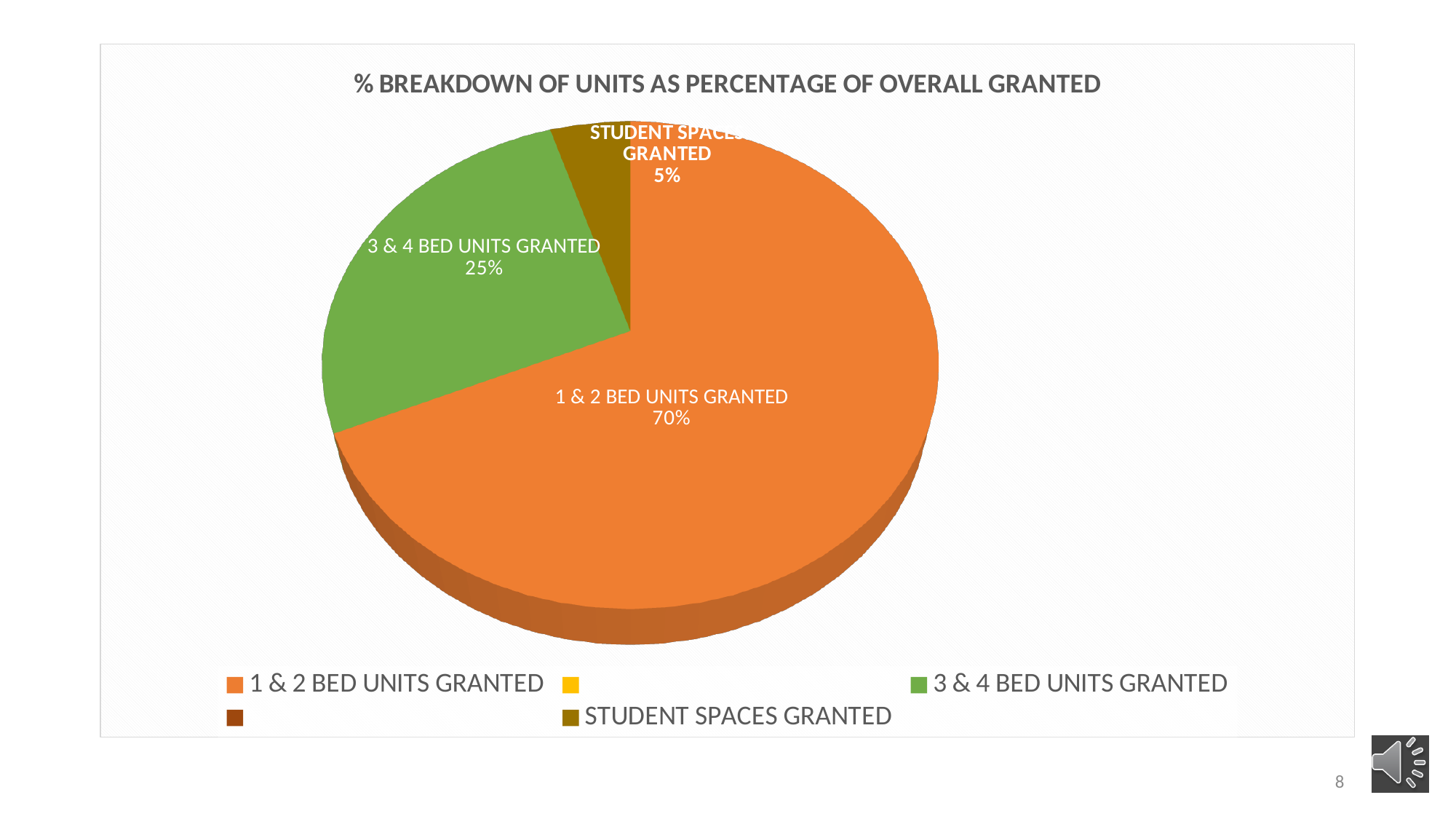
Which is larger, the share for 3 & 4 BED UNITS GRANTED or the share for STUDENT SPACES GRANTED? 3 & 4 BED UNITS GRANTED What is the difference in percentage points between 3 & 4 BED UNITS GRANTED and STUDENT SPACES GRANTED? 20 What type of chart is shown on the slide? pie chart Which category has the largest share of the pie? 1 & 2 BED UNITS GRANTED What percentage of the pie is 3 & 4 BED UNITS GRANTED? 25% What is the title of the chart? % BREAKDOWN OF UNITS AS PERCENTAGE OF OVERALL GRANTED What percentage of the pie is STUDENT SPACES GRANTED? 5% How many labelled slices does the pie chart have? 3 What percentage of the pie is 1 & 2 BED UNITS GRANTED? 70% What colour is the slice for 3 & 4 BED UNITS GRANTED? green Which category has the smallest share of the pie? STUDENT SPACES GRANTED What is the difference in percentage points between 1 & 2 BED UNITS GRANTED and 3 & 4 BED UNITS GRANTED? 45